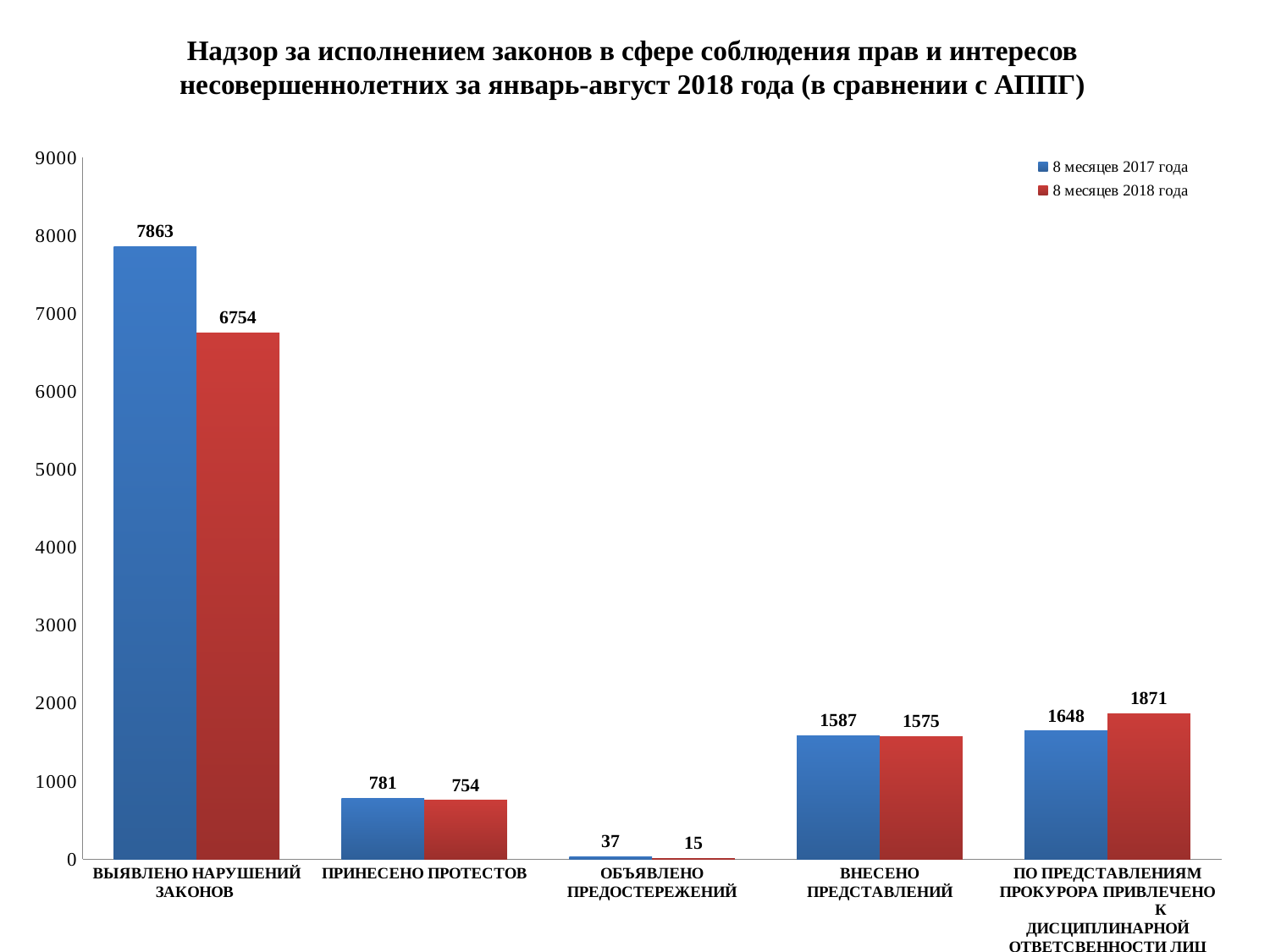
What is the value for "Выявлено нарушений законов" in the "8 месяцев 2017 года" series? 7863 How many categories are shown on the x axis? 5 What is the value for "Выявлено нарушений законов" in the "8 месяцев 2018 года" series? 6754 What is the value for "Внесено представлений" in the "8 месяцев 2017 года" series? 1587 What is the difference between the 2018 and 2017 values for "По представлениям прокурора привлечено к дисциплинарной ответственности лиц"? 223 Which category has the lowest value in the "8 месяцев 2017 года" series? Объявлено предостережений What kind of chart is shown on the slide? Bar chart Which category has the highest value in the "8 месяцев 2018 года" series? Выявлено нарушений законов What is the value for "Объявлено предостережений" in the "8 месяцев 2018 года" series? 15 What is the difference between the 2017 and 2018 values for "Выявлено нарушений законов"? 1109 How many series does the legend list? 2 For "Принесено протестов", which series has the larger value: "8 месяцев 2017 года" or "8 месяцев 2018 года"? 8 месяцев 2017 года